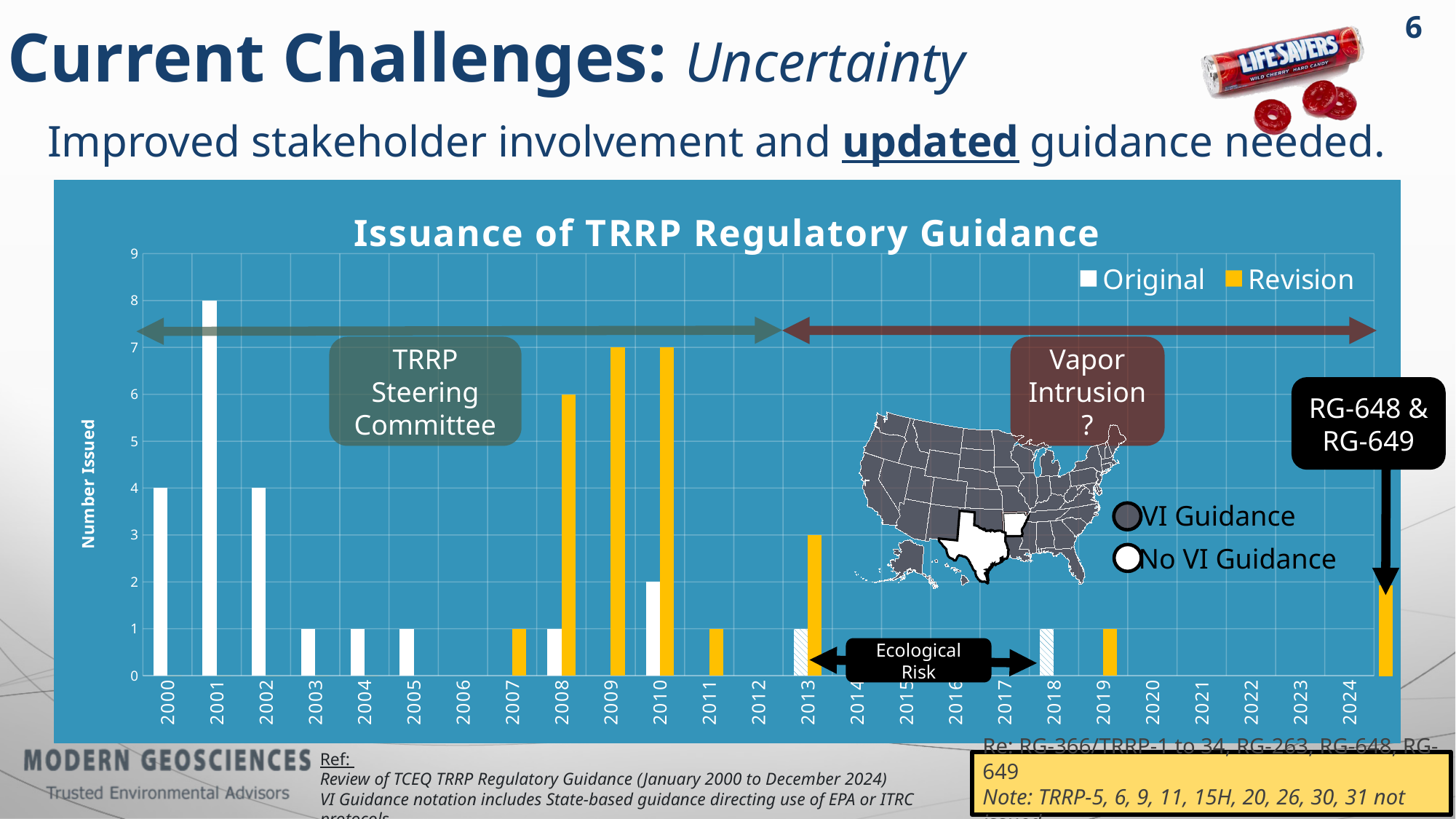
Is the number of Original documents issued in 2001 greater or less than 5? greater What type of chart is shown on the slide? bar chart How many series does the legend of the 'Issuance of TRRP Regulatory Guidance' chart list? 2 How many Original guidance documents were issued in 2001? 8 How many Original guidance documents were issued in 2000? 4 How many Revision guidance documents were issued in 2008? 6 In which year was the number of Original guidance documents issued the highest? 2001 What are the two series named in the legend of the chart? Original and Revision What is the difference between the number of Original documents issued in 2001 and in 2002? 4 How many years are shown on the x axis of the chart? 25 Which year had more Revision documents issued, 2008 or 2013? 2008 How many Revision guidance documents were issued in 2009? 7